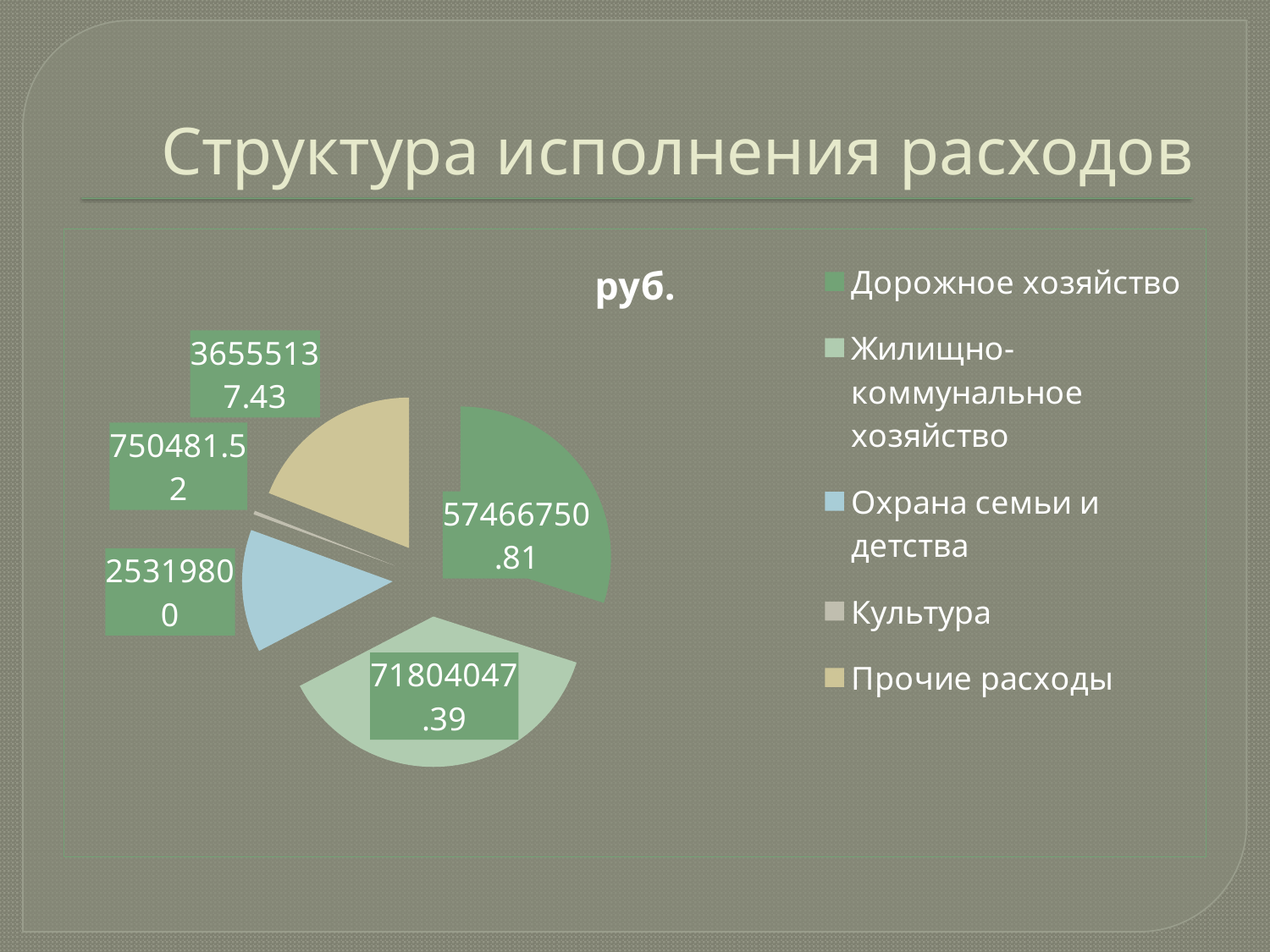
Which is larger, the value for Прочие расходы or the value for Охрана семьи и детства? Прочие расходы What is the title of the chart? руб. Which category has the smallest slice? Культура What is the value for Жилищно-коммунальное хозяйство? 71804047.39 What is the value for Прочие расходы? 36555137.43 What is the value for Охрана семьи и детства? 25319800 What is the value for Дорожное хозяйство? 57466750.81 What kind of chart is shown on the slide? Pie chart How many slices does the pie chart have? 5 What is the value for Культура? 750481.52 What is the difference between the values for Жилищно-коммунальное хозяйство and Дорожное хозяйство? 14337296.58 Which category has the largest slice? Жилищно-коммунальное хозяйство